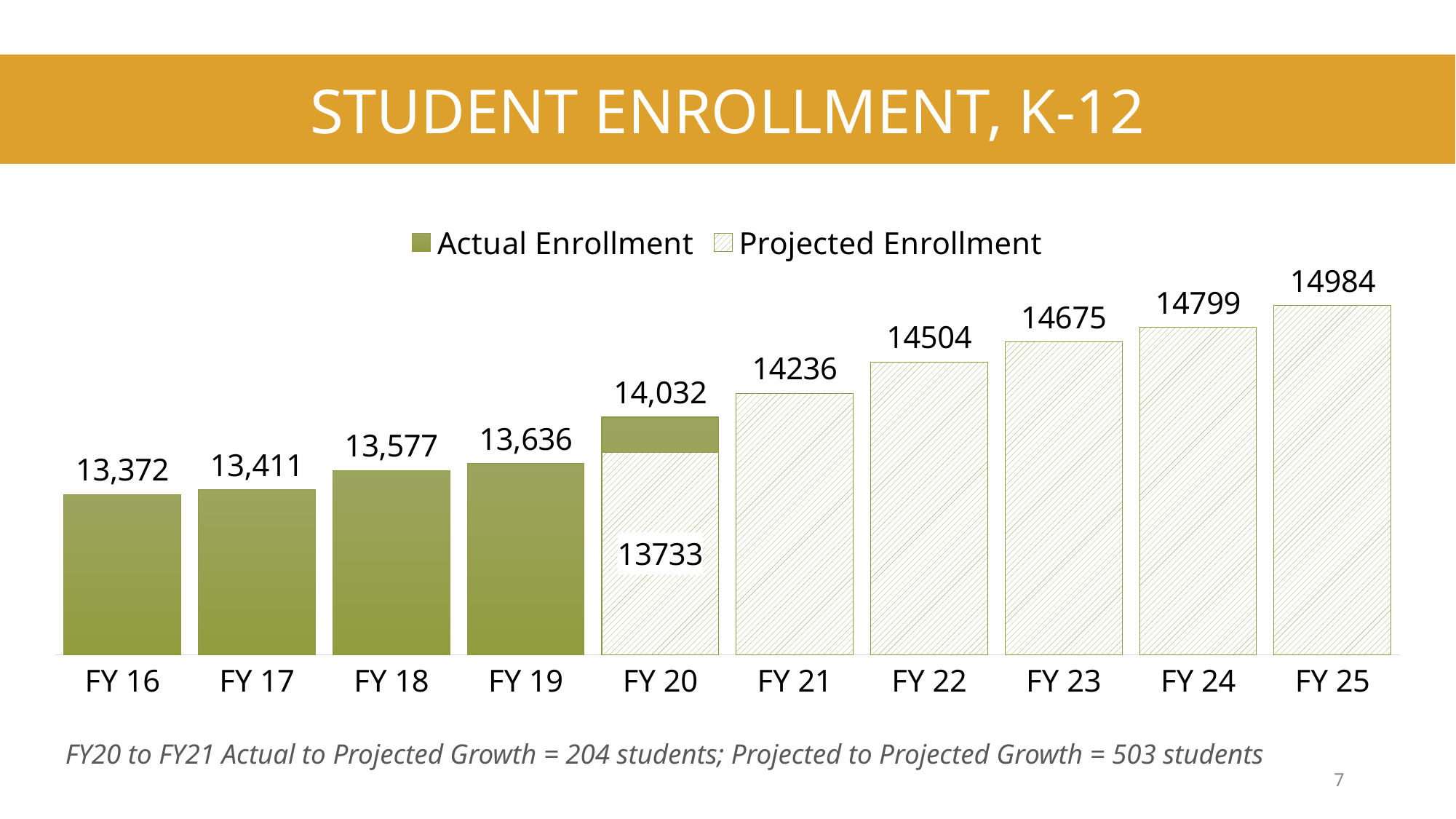
What is the actual enrollment for FY 16? 13,372 Which fiscal year has the lowest enrollment value on the chart? FY 16 Which fiscal year has the highest enrollment value on the chart? FY 25 What is the difference between the projected enrollment for FY 25 and FY 21? 748 What is the projected enrollment for FY 25? 14984 What is the actual enrollment for FY 19? 13,636 What is the difference between the actual enrollment and the projected enrollment for FY 20? 299 Which is larger, the actual enrollment for FY 18 or for FY 17? FY 18 Do the enrollment values rise or fall from FY 16 to FY 25? Rise What is the projected enrollment value shown for FY 20? 13733 How many fiscal years are shown on the x axis? 10 How many series does the legend list? 2